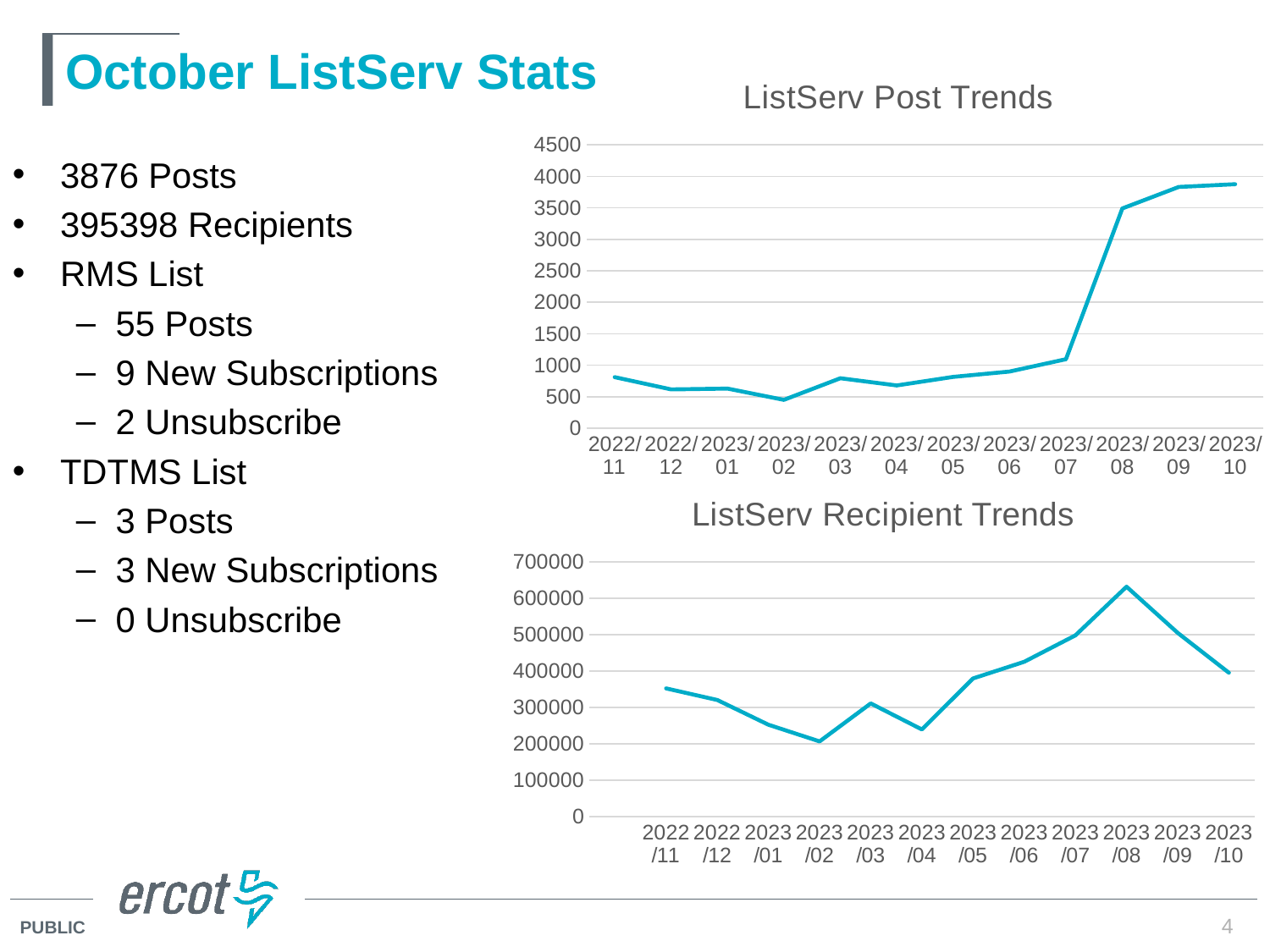
On the "ListServ Recipient Trends" chart, which month has the lowest value? 2023/02 On the "ListServ Post Trends" chart, is the value for 2023/08 greater or less than 3000? greater On the "ListServ Post Trends" chart, which month has the lowest value? 2023/02 On the "ListServ Post Trends" chart, is the value for 2023/02 greater or less than 1000? less On the "ListServ Post Trends" chart, which month has the highest value? 2023/10 On the "ListServ Recipient Trends" chart, is the value for 2023/04 greater or less than 300000? less On the "ListServ Recipient Trends" chart, which is larger, the value for 2023/09 or the value for 2023/10? 2023/09 What kind of chart is the "ListServ Post Trends" chart? line chart How many data points are plotted on the "ListServ Recipient Trends" chart? 12 On the "ListServ Recipient Trends" chart, which month has the highest value? 2023/08 On the "ListServ Post Trends" chart, do the values generally rise or fall from 2023/07 to 2023/10? rise